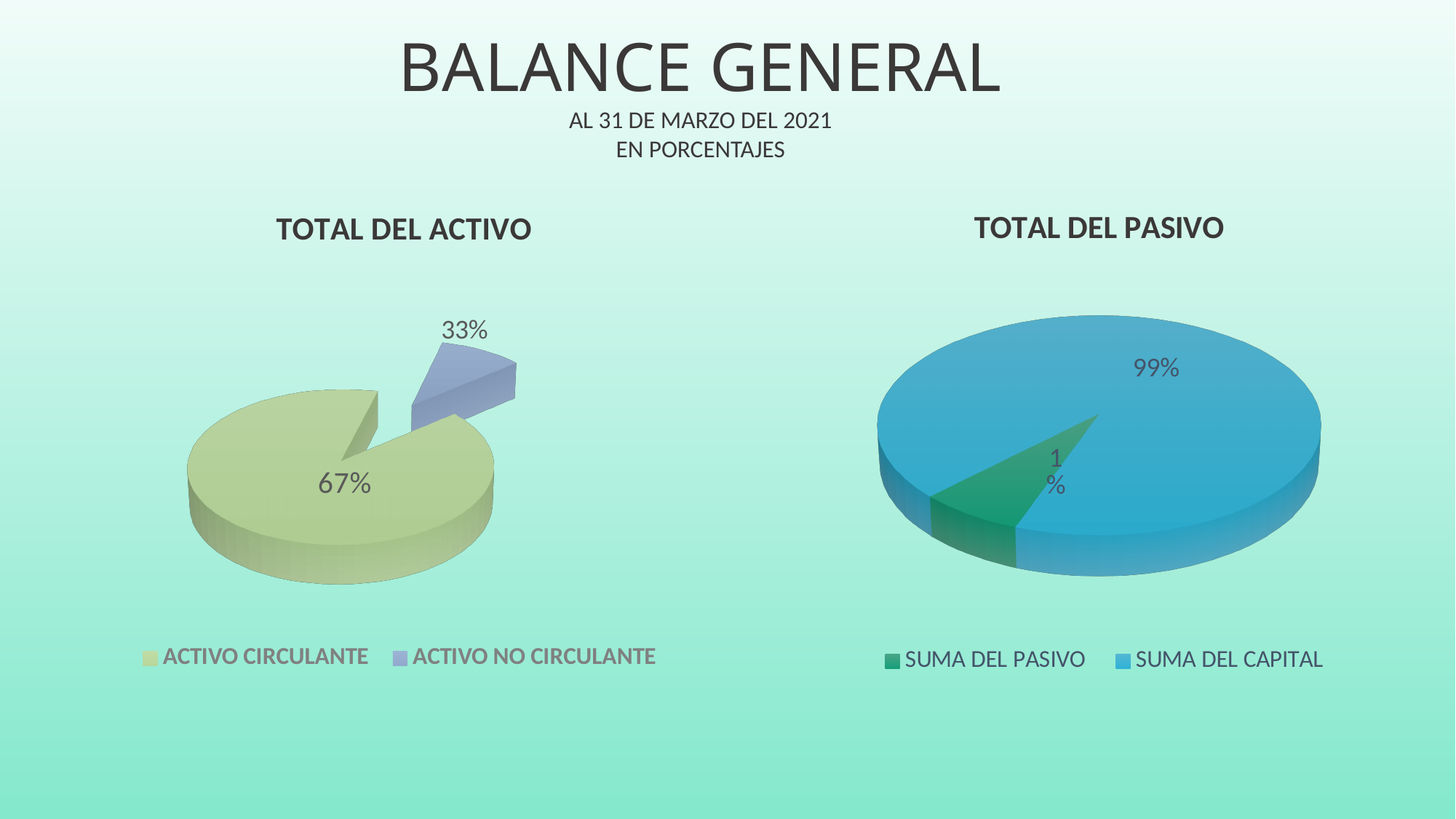
How many entries does the legend of the TOTAL DEL PASIVO chart list? 2 In the TOTAL DEL ACTIVO chart, which is larger: ACTIVO CIRCULANTE or ACTIVO NO CIRCULANTE? ACTIVO CIRCULANTE How many slices does the TOTAL DEL ACTIVO chart have? 2 In the TOTAL DEL ACTIVO chart, which slice is the largest? ACTIVO CIRCULANTE In the TOTAL DEL PASIVO chart, what share does SUMA DEL PASIVO have? 1% In the TOTAL DEL ACTIVO chart, what share does ACTIVO CIRCULANTE have? 67% In the TOTAL DEL PASIVO chart, which slice is the smallest? SUMA DEL PASIVO In the TOTAL DEL PASIVO chart, what share does SUMA DEL CAPITAL have? 99% In the TOTAL DEL ACTIVO chart, what is the difference between the ACTIVO CIRCULANTE and ACTIVO NO CIRCULANTE shares? 34% In the TOTAL DEL PASIVO chart, what is the difference between the SUMA DEL CAPITAL and SUMA DEL PASIVO shares? 98% What kind of chart is the TOTAL DEL PASIVO chart? Pie chart